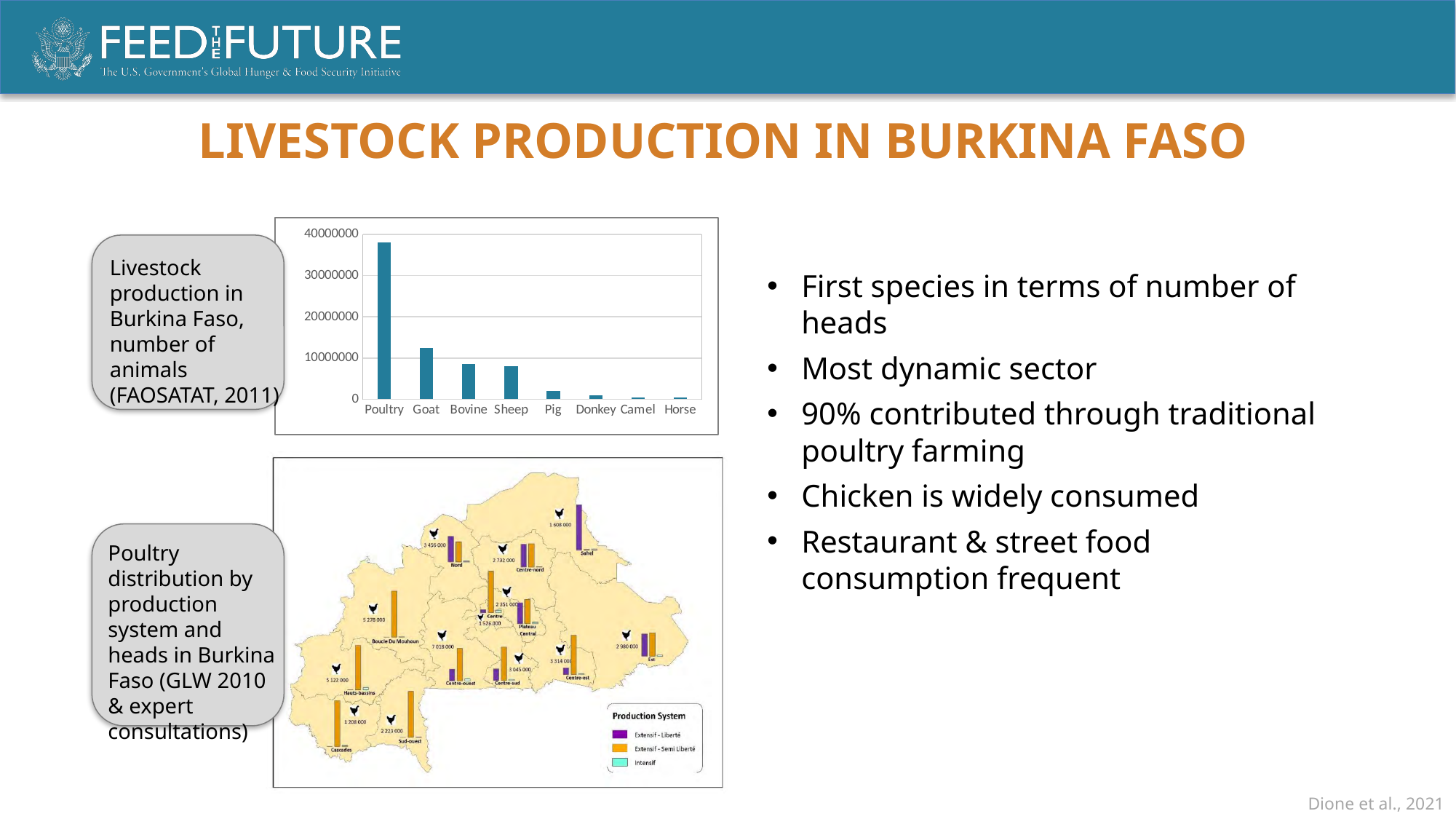
In the bar chart at the top of the slide, what kind of chart is used to show livestock production in Burkina Faso? bar chart In the bar chart at the top of the slide, which has a larger value, Goat or Bovine? Goat In the bar chart at the top of the slide, how many animal categories are shown on the x axis? 8 In the bar chart at the top of the slide, is the value for Poultry greater or less than 30000000? greater In the bar chart at the top of the slide, which animal category has the highest number of animals? Poultry In the bar chart at the top of the slide, which has a larger value, Pig or Donkey? Pig In the bar chart at the top of the slide, is the value for Pig greater or less than 10000000? less In the bar chart at the top of the slide, what is the highest value shown on the y axis? 40000000 In the map at the bottom of the slide, how many production systems does the legend list? 3 In the bar chart at the top of the slide, is the value for Goat greater or less than 10000000? greater In the bar chart at the top of the slide, do the values rise or fall moving from Poultry on the left to Horse on the right? fall